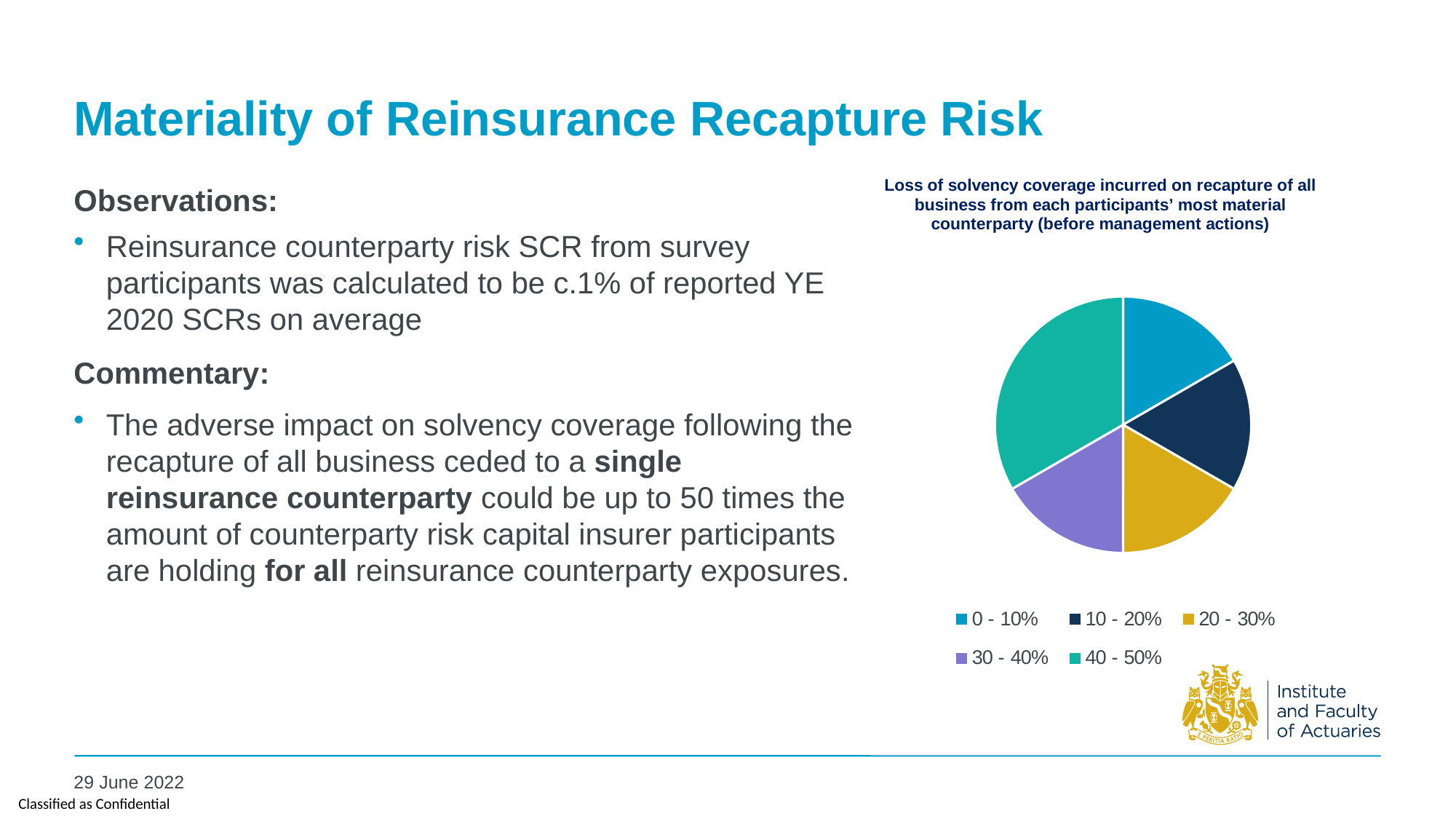
Which category has the largest slice of the pie chart? 40 - 50% Which slice is larger in the pie chart, 40 - 50% or 20 - 30%? 40 - 50% Which slice is larger in the pie chart, 40 - 50% or 30 - 40%? 40 - 50% What is the title of the pie chart? Loss of solvency coverage incurred on recapture of all business from each participants' most material counterparty (before management actions) Which slice is larger in the pie chart, 40 - 50% or 0 - 10%? 40 - 50% How many entries does the legend of the pie chart list? 5 Which category is shown in purple in the pie chart? 30 - 40% What kind of chart is shown on the slide? pie chart How many slices does the pie chart have? 5